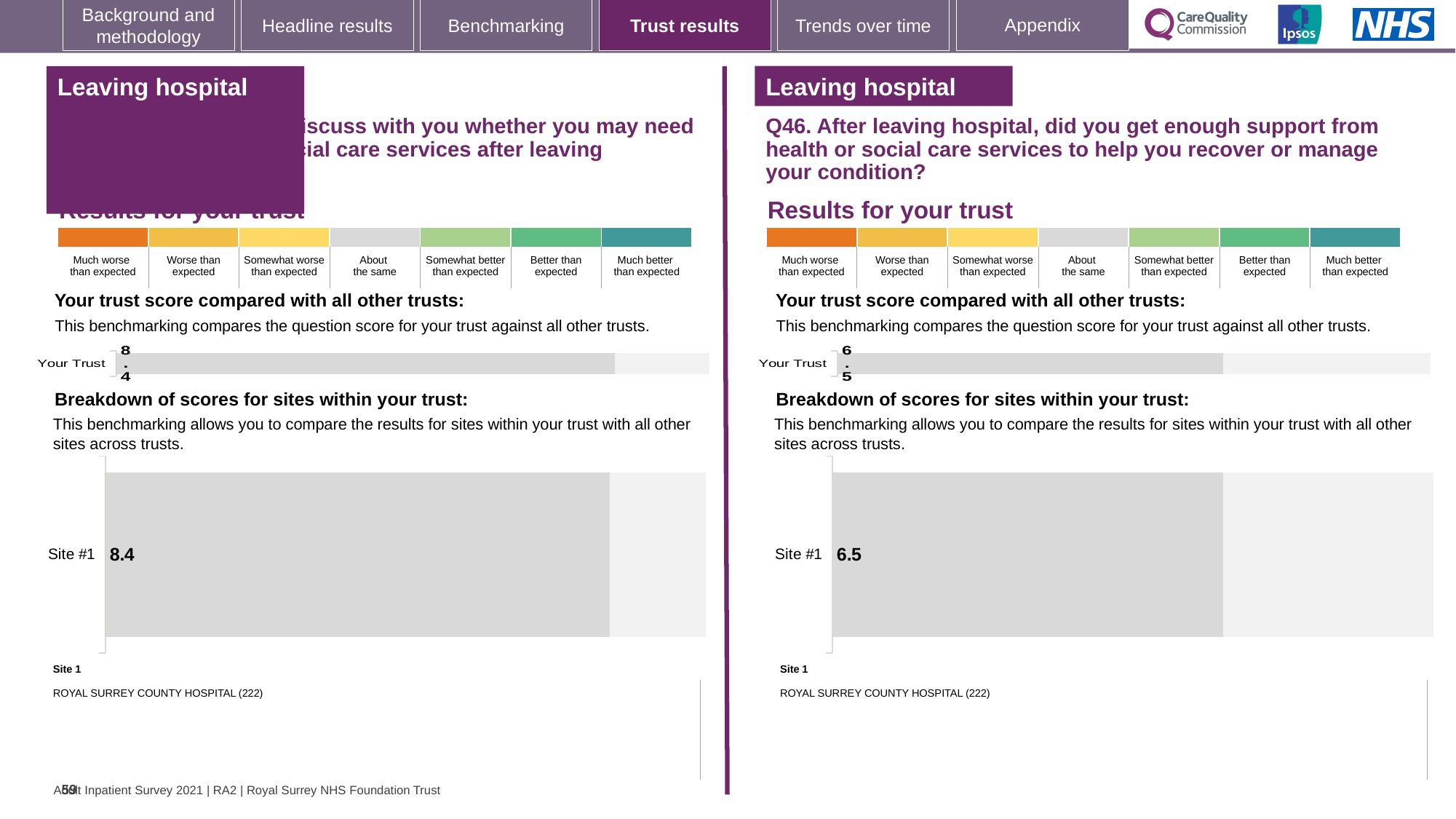
What is the difference between the Site #1 score on the left-hand breakdown chart and the Site #1 score on the right-hand breakdown chart for Q46? 1.9 On the right-hand chart for Q46, what is the score shown for 'Your Trust'? 6.5 In the left-hand 'Breakdown of scores for sites within your trust' chart, what is the score for Site #1? 8.4 How many sites are shown in the left-hand 'Breakdown of scores for sites within your trust' chart? 1 How many sites are shown in the right-hand 'Breakdown of scores for sites within your trust' chart for Q46? 1 Which hospital is listed as Site 1 beneath the right-hand breakdown chart for Q46? ROYAL SURREY COUNTY HOSPITAL (222) How many categories are shown in the colour scale legend above the right-hand 'Results for your trust' section for Q46? 7 What type of chart is used to show the 'Your Trust' score on the right-hand side for Q46? Bar chart On the left-hand chart, what is the score shown for 'Your Trust'? 8.4 In the right-hand 'Breakdown of scores for sites within your trust' chart (Q46), what is the score for Site #1? 6.5 Which is larger: the 'Your Trust' score on the left-hand chart or the 'Your Trust' score on the right-hand chart for Q46? The left-hand chart (8.4)